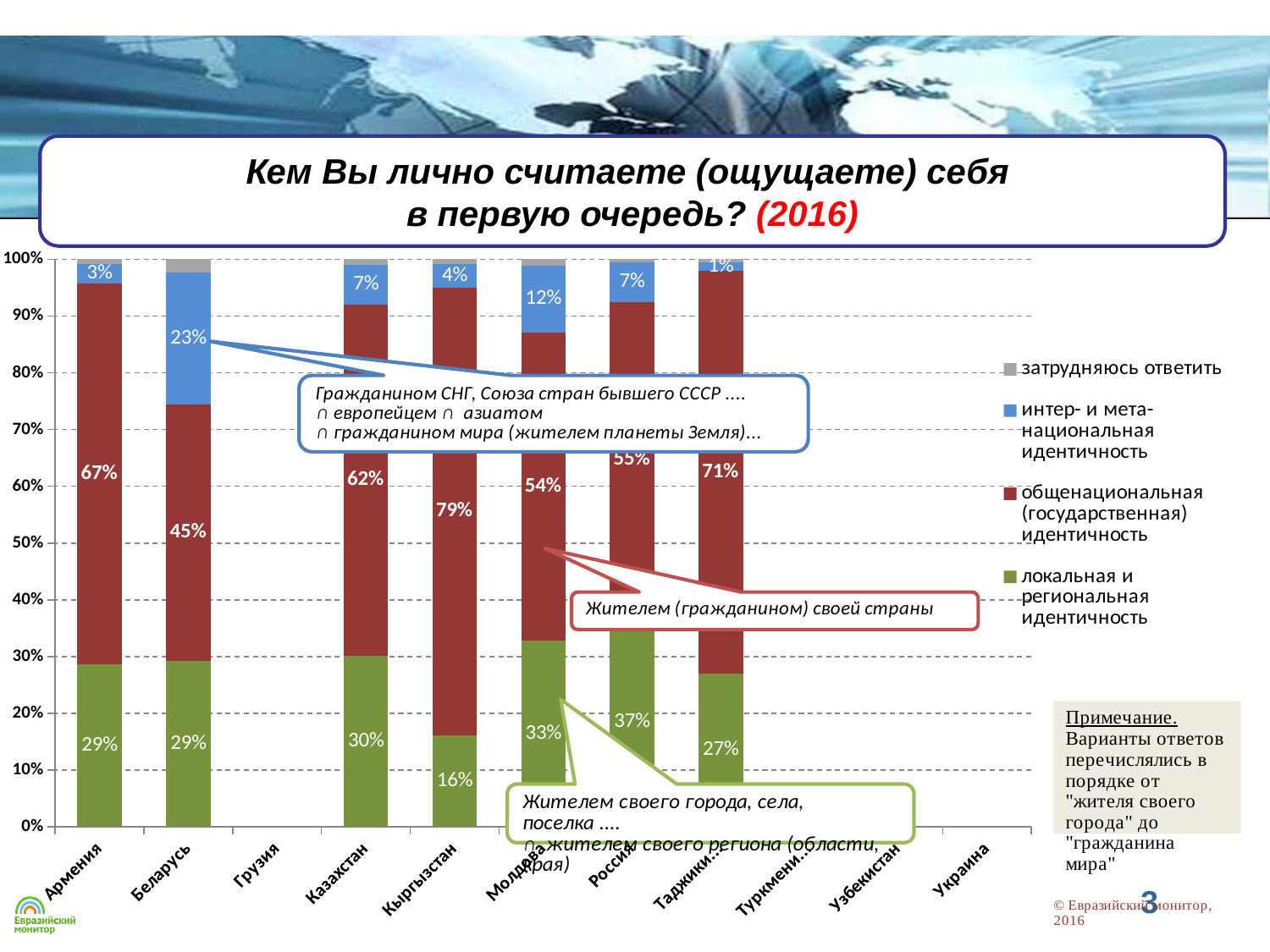
Which country has the lowest share for общенациональная (государственная) идентичность? Беларусь How many series does the legend list? 4 Which country has the lowest share for локальная и региональная идентичность? Кыргызстан In Казахстан, what is the difference between the общенациональная (государственная) идентичность share and the локальная и региональная идентичность share? 32 percentage points Which year is indicated in the chart title? 2016 Which country has the larger share for локальная и региональная идентичность, Россия or Молдова? Россия What is the value for интер- и мета-национальная идентичность in Молдова? 12% Which country has the highest share for общенациональная (государственная) идентичность? Кыргызстан What percentage of respondents in Армения chose общенациональная (государственная) идентичность? 67% What kind of chart is shown on the slide? Stacked bar chart What share of respondents in Кыргызстан chose локальная и региональная идентичность? 16% What is the value for интер- и мета-национальная идентичность in Беларусь? 23%